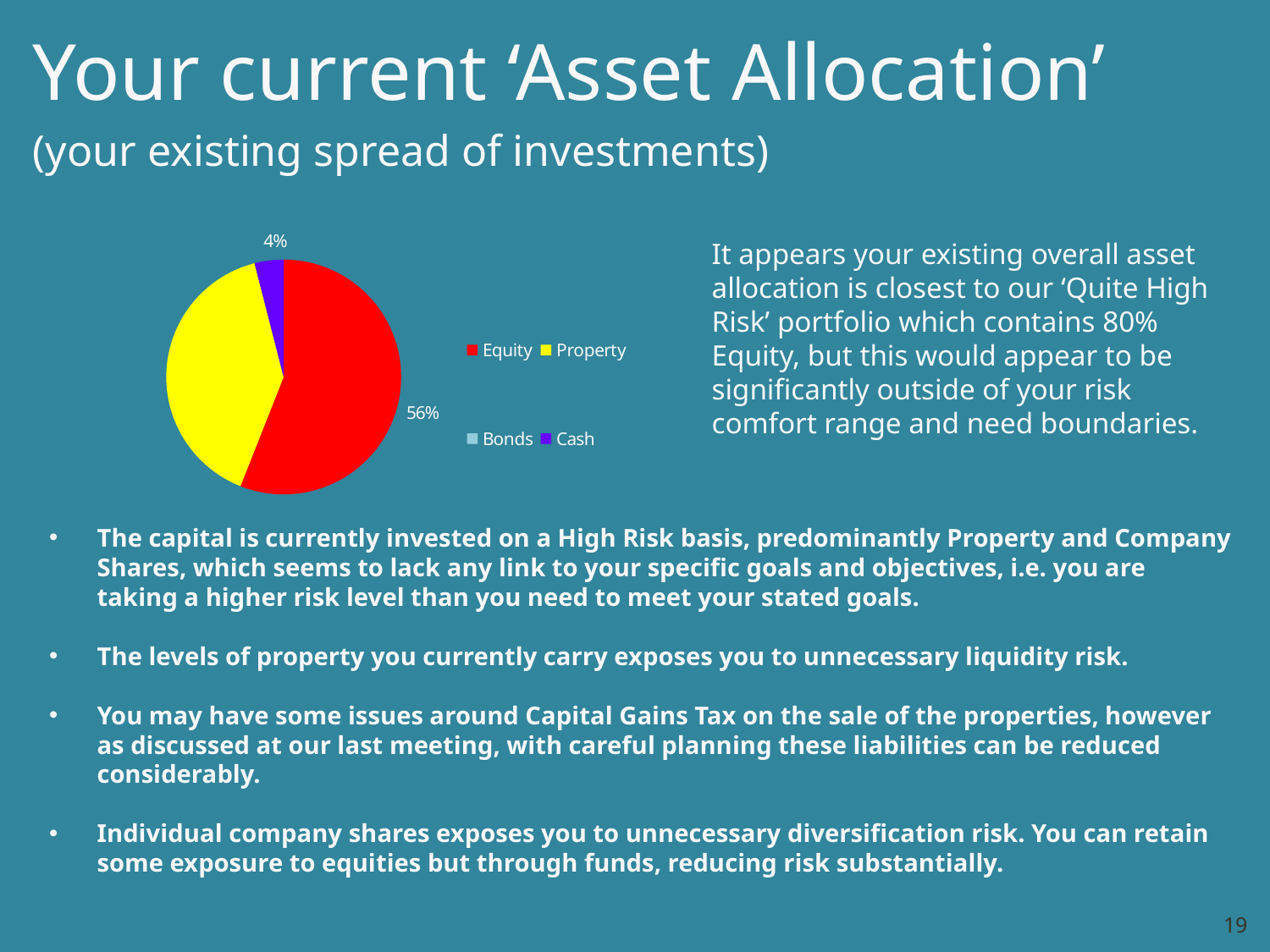
What colour represents Property in the pie chart? yellow How many asset classes are listed in the chart legend? 4 Is the Equity share greater or less than 50%? greater Which is larger, the Equity slice or the Property slice? Equity What colour represents Equity in the pie chart? red What type of chart is shown on the slide? pie chart Which asset class has the largest share of the pie? Equity What percentage of the asset allocation is Cash? 4% Which is larger, the Property slice or the Cash slice? Property What is the difference in percentage points between the Equity share and the Cash share? 52% What percentage of the asset allocation is Equity? 56%